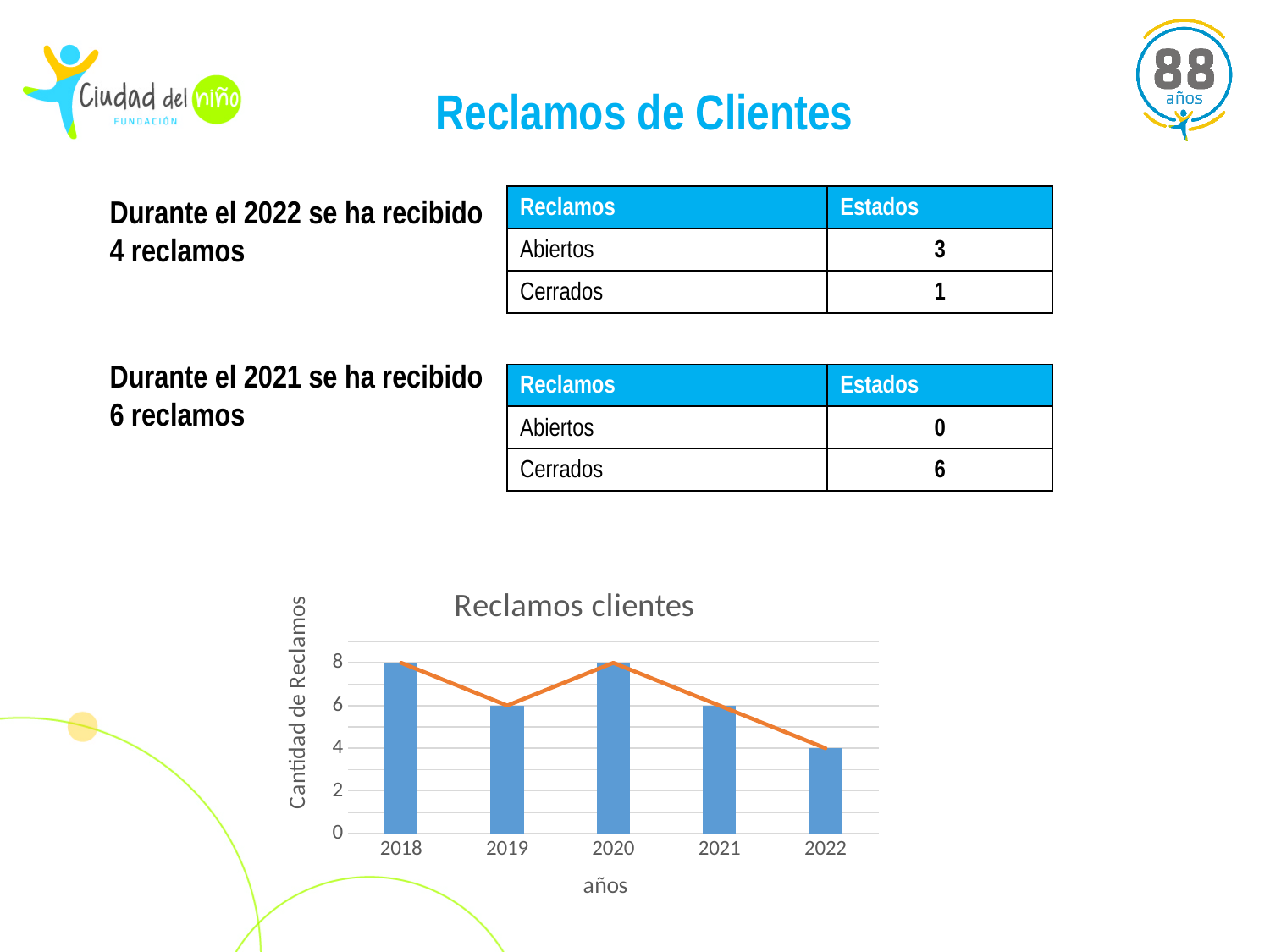
In the chart 'Reclamos clientes', what is the difference between the values for 2018 and 2021? 2 In the chart 'Reclamos clientes', which year has the lowest number of reclamos? 2022 What kind of chart is 'Reclamos clientes'? bar chart with a line overlay In the chart 'Reclamos clientes', what is the value for 2019? 6 In the chart 'Reclamos clientes', what is the value for 2018? 8 In the chart 'Reclamos clientes', do the values rise or fall from 2020 to 2022? fall In the chart 'Reclamos clientes', what is the difference between the values for 2020 and 2022? 4 In the chart 'Reclamos clientes', which is larger, the value for 2018 or the value for 2019? 2018 How many years are shown on the x axis of the chart 'Reclamos clientes'? 5 In the chart 'Reclamos clientes', which is larger, the value for 2021 or the value for 2022? 2021 What is the label of the y axis in the chart 'Reclamos clientes'? Cantidad de Reclamos In the chart 'Reclamos clientes', what is the value for 2022? 4